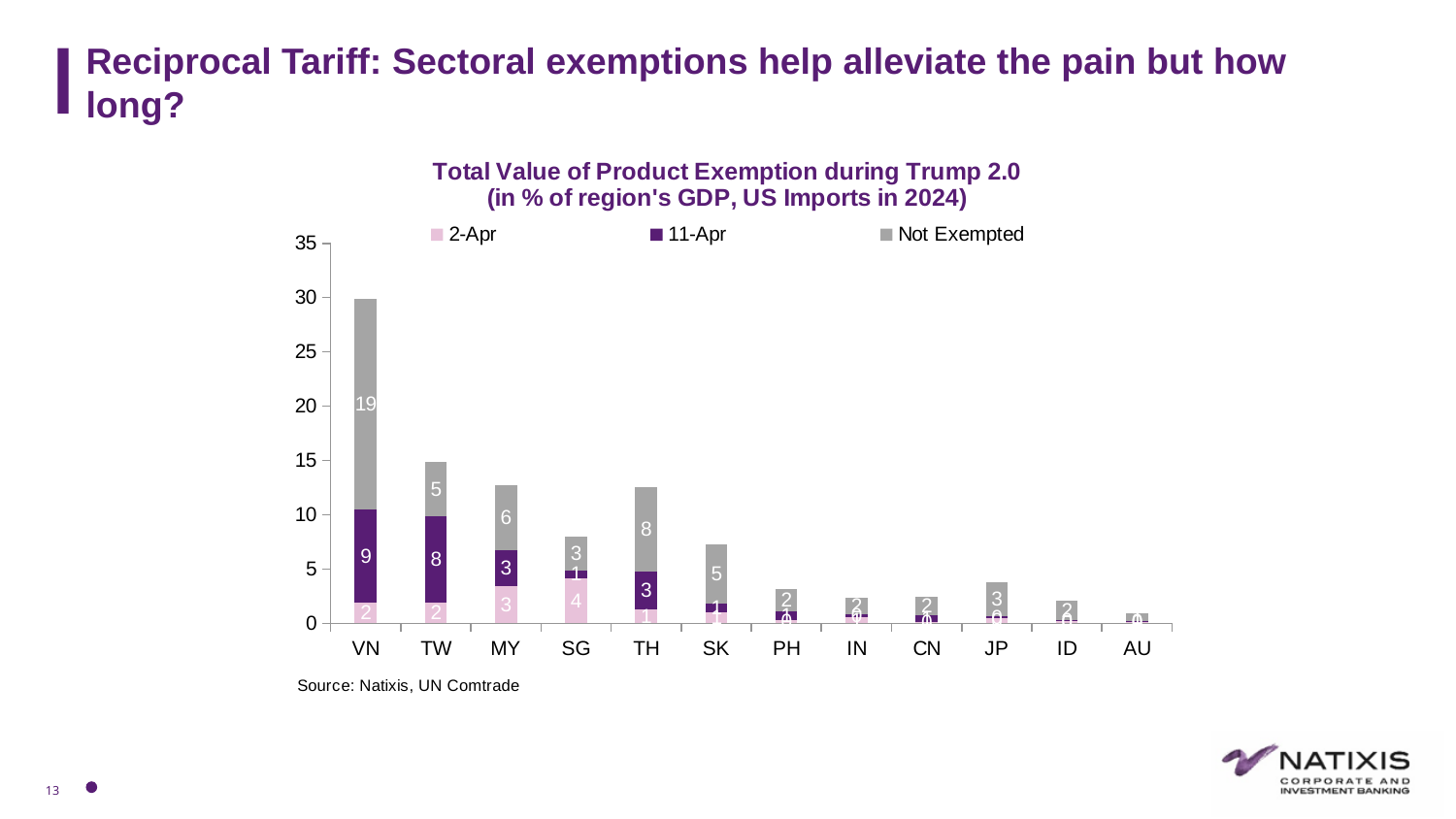
Is the total bar height for SK greater or less than 10? less What are the three legend entries of the chart? 2-Apr, 11-Apr, Not Exempted What is the 2-Apr value for SG? 4 How many regions are shown on the x axis? 12 What is the difference between the 11-Apr value for VN and the 11-Apr value for TW? 1 What is the Not Exempted value for TH? 8 What is the 11-Apr value for TW? 8 Which region has the tallest total bar? VN How many series does the legend list? 3 Which is larger, the Not Exempted value for TH or for TW? TH What kind of chart is shown on the slide? Stacked bar chart What is the Not Exempted value for VN? 19